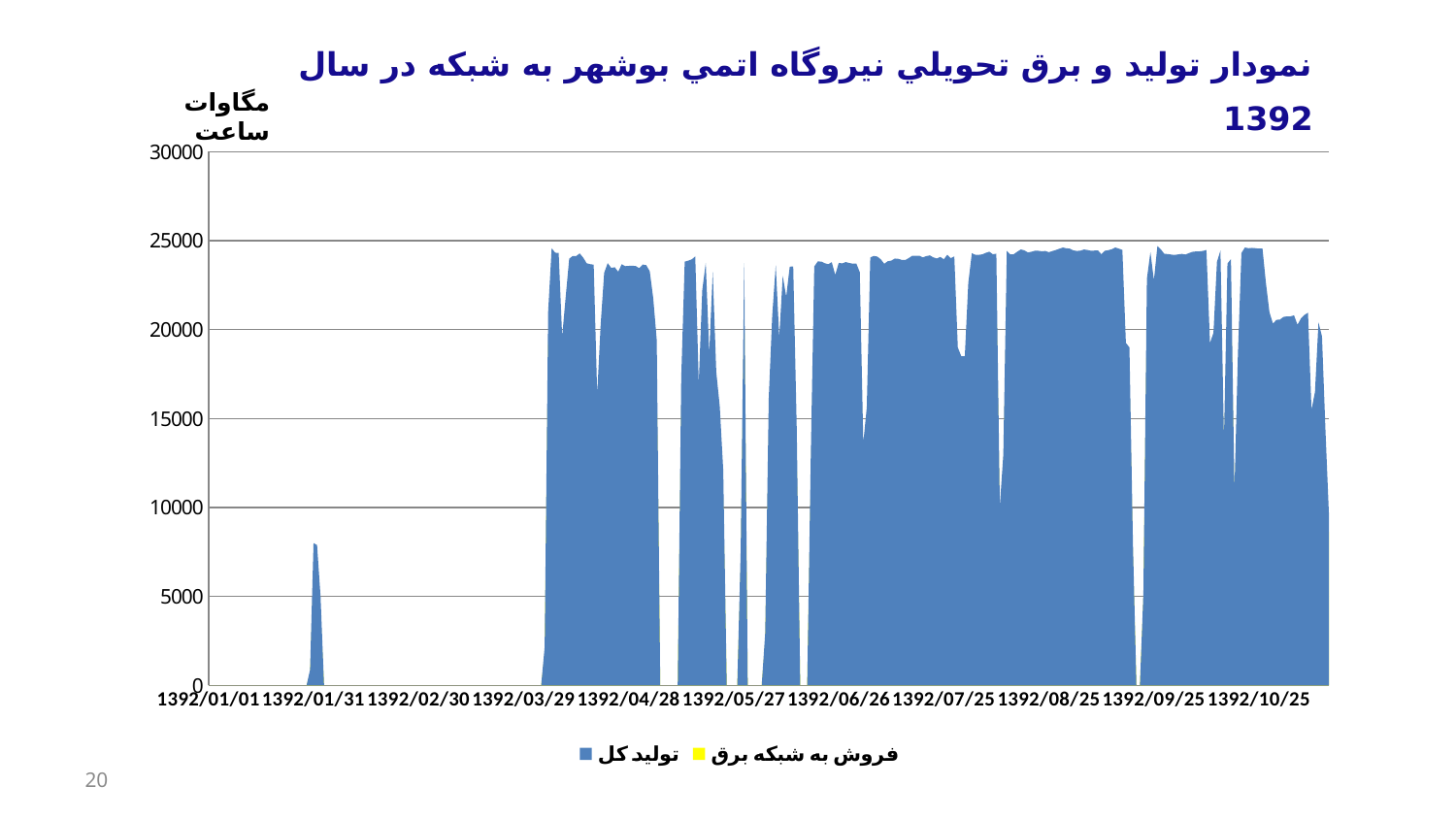
How many date labels are shown along the horizontal axis? 11 What is the first date label on the horizontal axis? 1392/01/01 Is the value of the blue series at 1392/02/30 greater or less than 5000? less Is the value of the blue series around 1392/08/25 greater or less than 20000? greater Which is larger for the blue series: the value around 1392/01/31 or the value around 1392/07/25? 1392/07/25 What kind of chart is shown on the slide? Area chart Is the value of the blue series at 1392/03/29 greater or less than 15000? less What is the highest value shown on the vertical axis? 30000 What unit label is written above the vertical axis? مگاوات ساعت How many series does the legend list? 2